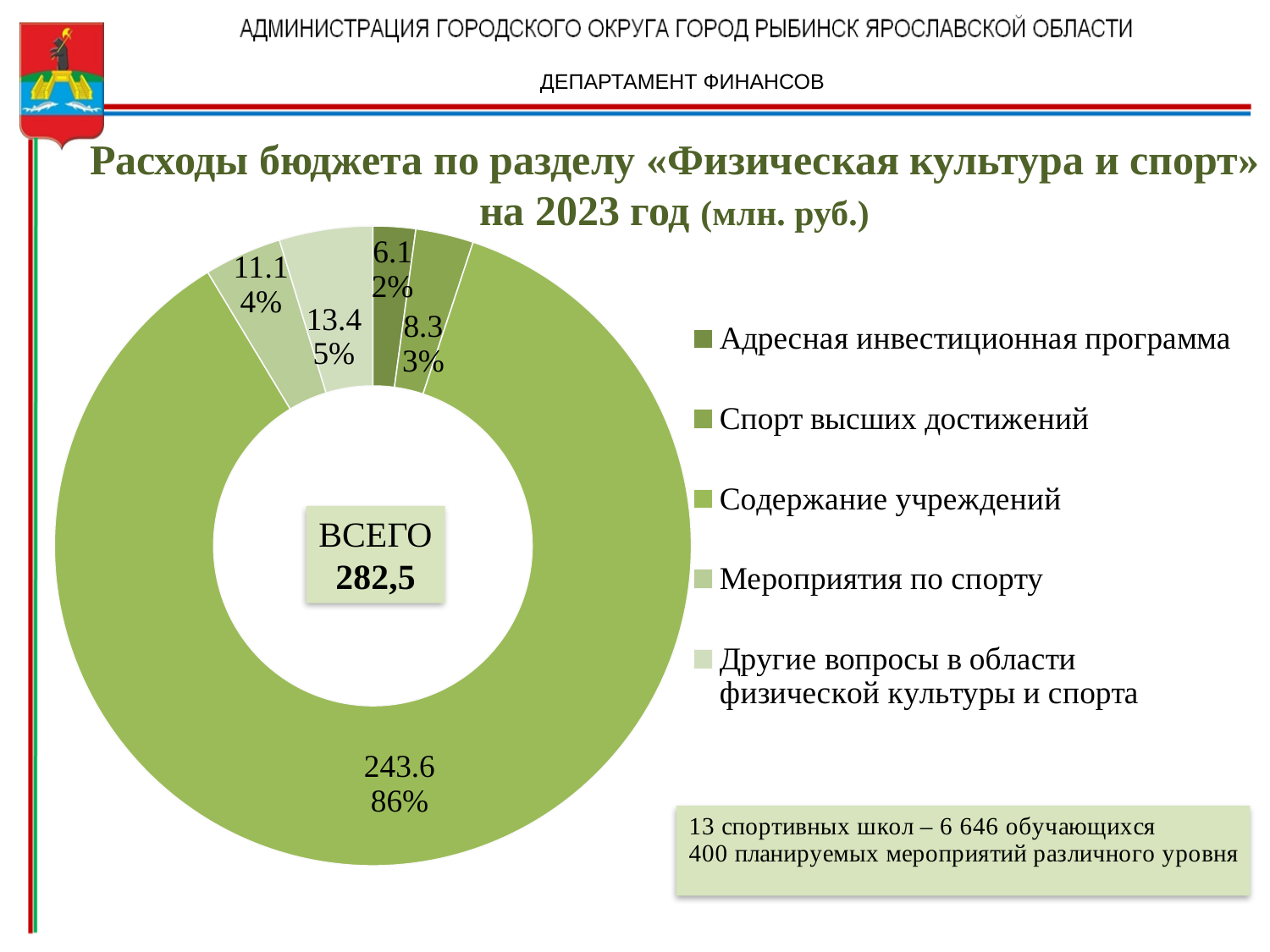
What is the difference between the values for «Другие вопросы в области физической культуры и спорта» and «Мероприятия по спорту»? 2.3 What percentage share is shown for «Другие вопросы в области физической культуры и спорта»? 5% Which category has the largest slice? Содержание учреждений What is the value for «Адресная инвестиционная программа»? 6.1 How many categories does the legend list? 5 What share of the total does «Содержание учреждений» account for? 86% Which category has the smallest slice? Адресная инвестиционная программа What is the value for «Мероприятия по спорту»? 11.1 What is the value for «Содержание учреждений»? 243.6 What kind of chart is shown on the slide? doughnut (pie) chart What is the value for «Спорт высших достижений»? 8.3 What total (ВСЕГО) is shown in the centre of the chart? 282,5